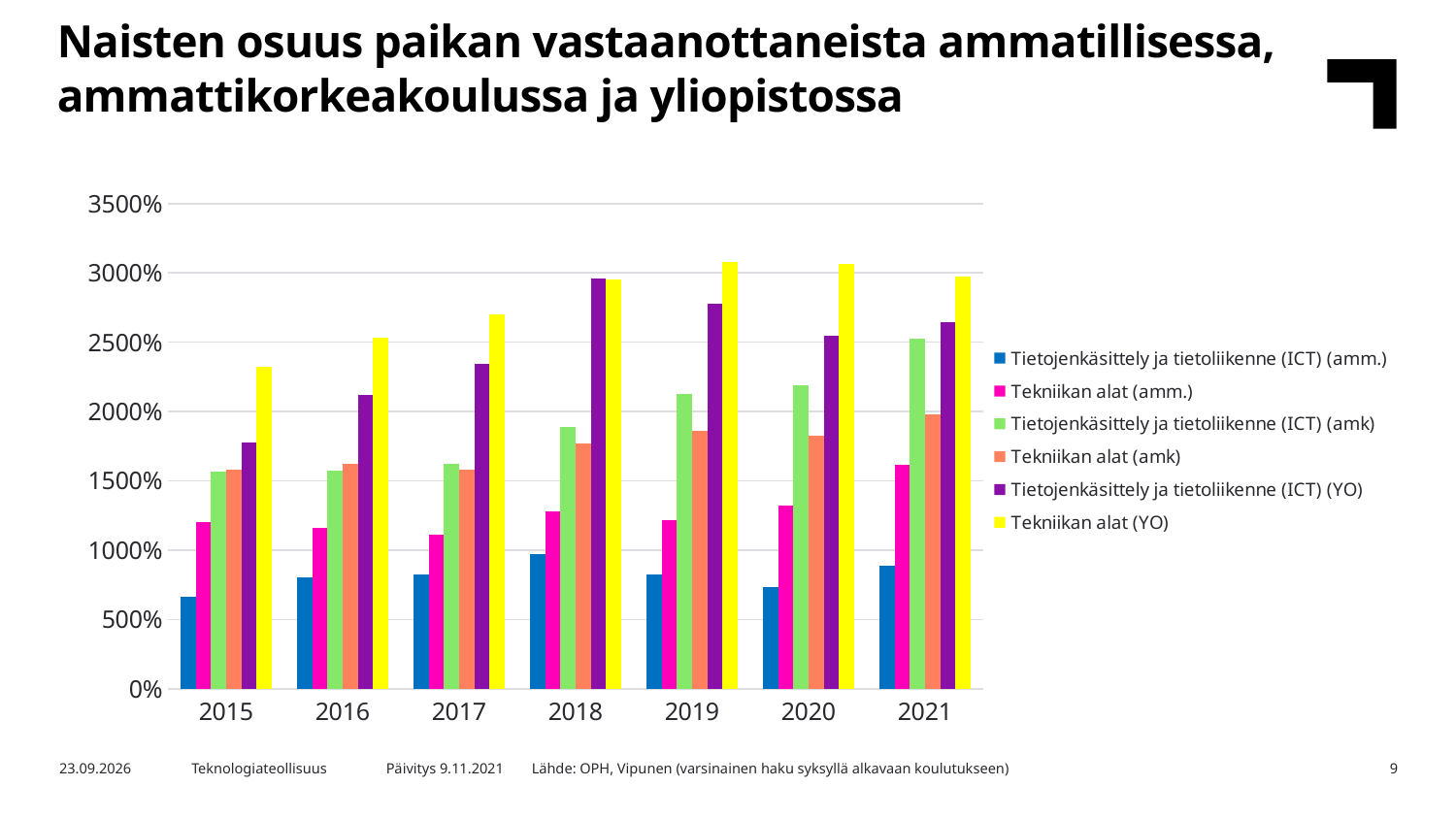
How many years are shown on the x axis of the chart? 7 Is the value for Tietojenkäsittely ja tietoliikenne (ICT) (amk) in 2020 greater or less than 2000%? greater Does the value for Tietojenkäsittely ja tietoliikenne (ICT) (YO) rise or fall from 2015 to 2018? rise Which series has the lowest value in every year shown? Tietojenkäsittely ja tietoliikenne (ICT) (amm.) Is the value for Tietojenkäsittely ja tietoliikenne (ICT) (YO) in 2017 greater or less than 2500%? less What kind of chart is shown on the slide? bar chart Is the value for Tietojenkäsittely ja tietoliikenne (ICT) (amm.) in 2015 greater or less than 500%? greater How many series does the chart's legend list? 6 In 2021, which is larger: Tietojenkäsittely ja tietoliikenne (ICT) (amk) or Tekniikan alat (amk)? Tietojenkäsittely ja tietoliikenne (ICT) (amk) Which series has the highest value in 2017? Tekniikan alat (YO)